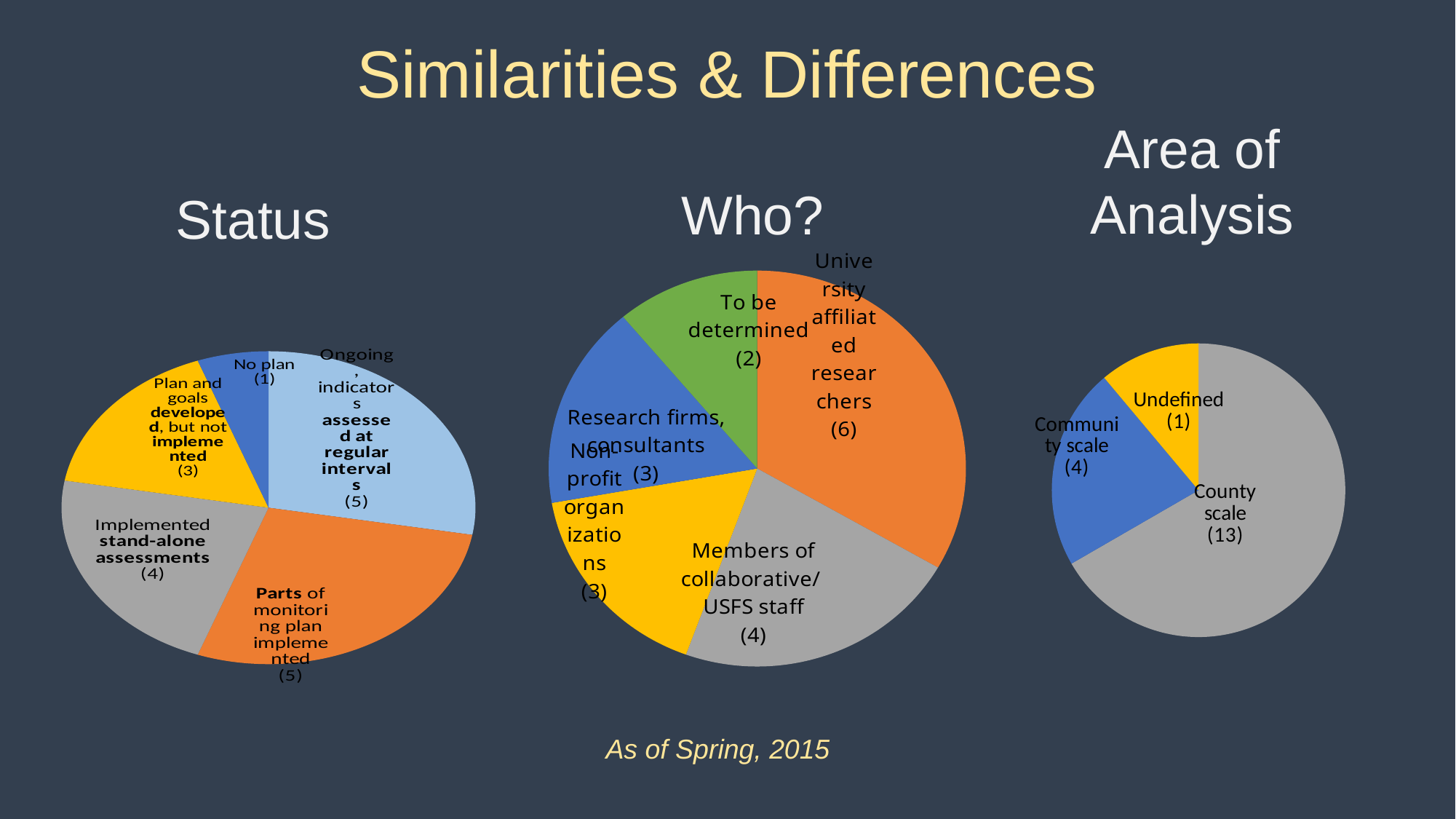
How many categories does the 'Area of Analysis' chart show? 3 In the 'Area of Analysis' chart, what is the value for 'County scale'? 13 In the 'Area of Analysis' chart, which is larger, 'Community scale' or 'Undefined'? Community scale In the 'Status' chart, what is the value for 'No plan'? 1 In the 'Who?' chart, what is the difference between 'University affiliated researchers' and 'To be determined'? 4 What kind of chart is used for the 'Status' chart? pie chart How many categories does the 'Status' chart show? 5 In the 'Area of Analysis' chart, what share of the total does 'County scale' represent? 13/18 In the 'Who?' chart, what is the value for 'Members of collaborative/USFS staff'? 4 In the 'Who?' chart, which category has the highest value? University affiliated researchers In the 'Who?' chart, which category has the lowest value? To be determined In the 'Status' chart, what is the value for 'Implemented stand-alone assessments'? 4